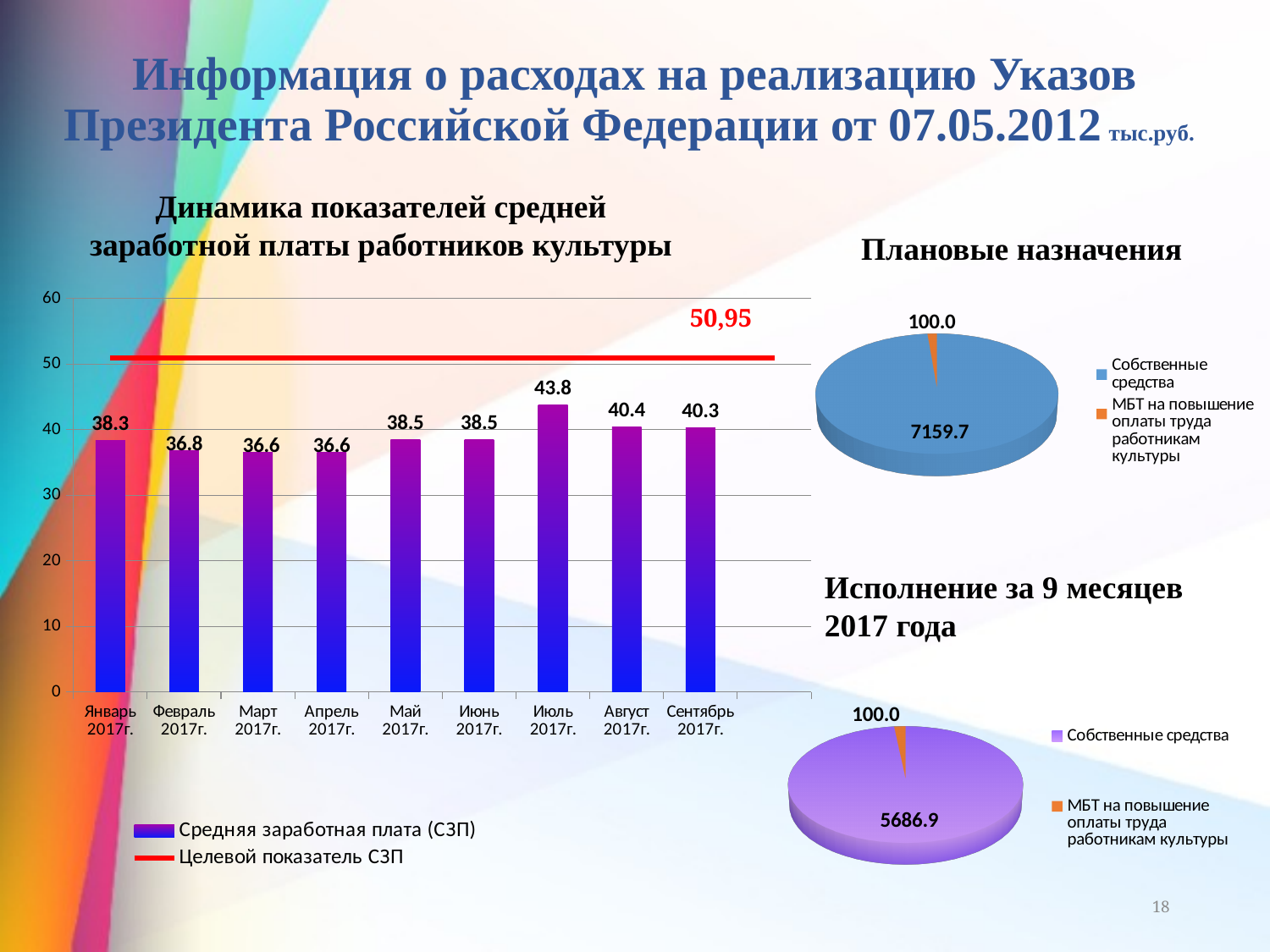
In the chart 'Исполнение за 9 месяцев 2017 года', what is the value for Собственные средства? 5686.9 In the chart 'Динамика показателей средней заработной платы работников культуры', how many months are shown on the x axis? 9 In the chart 'Динамика показателей средней заработной платы работников культуры', how many entries does the legend list? 2 In the chart 'Динамика показателей средней заработной платы работников культуры', what is the value for Январь 2017г.? 38.3 What kind of chart is 'Плановые назначения'? Pie chart In the chart 'Динамика показателей средней заработной платы работников культуры', what is the value of the target indicator (Целевой показатель СЗП)? 50,95 In the chart 'Плановые назначения', what is the value for Собственные средства? 7159.7 In the chart 'Динамика показателей средней заработной платы работников культуры', which is larger: the value for Август 2017г. or Сентябрь 2017г.? Август 2017г. In the chart 'Динамика показателей средней заработной платы работников культуры', what is the value for Июль 2017г.? 43.8 In the chart 'Динамика показателей средней заработной платы работников культуры', which month has the highest average salary? Июль 2017г. In the chart 'Динамика показателей средней заработной платы работников культуры', what is the difference between the values for Июль 2017г. and Февраль 2017г.? 7.0 In the chart 'Исполнение за 9 месяцев 2017 года', what is the value for МБТ на повышение оплаты труда работникам культуры? 100.0